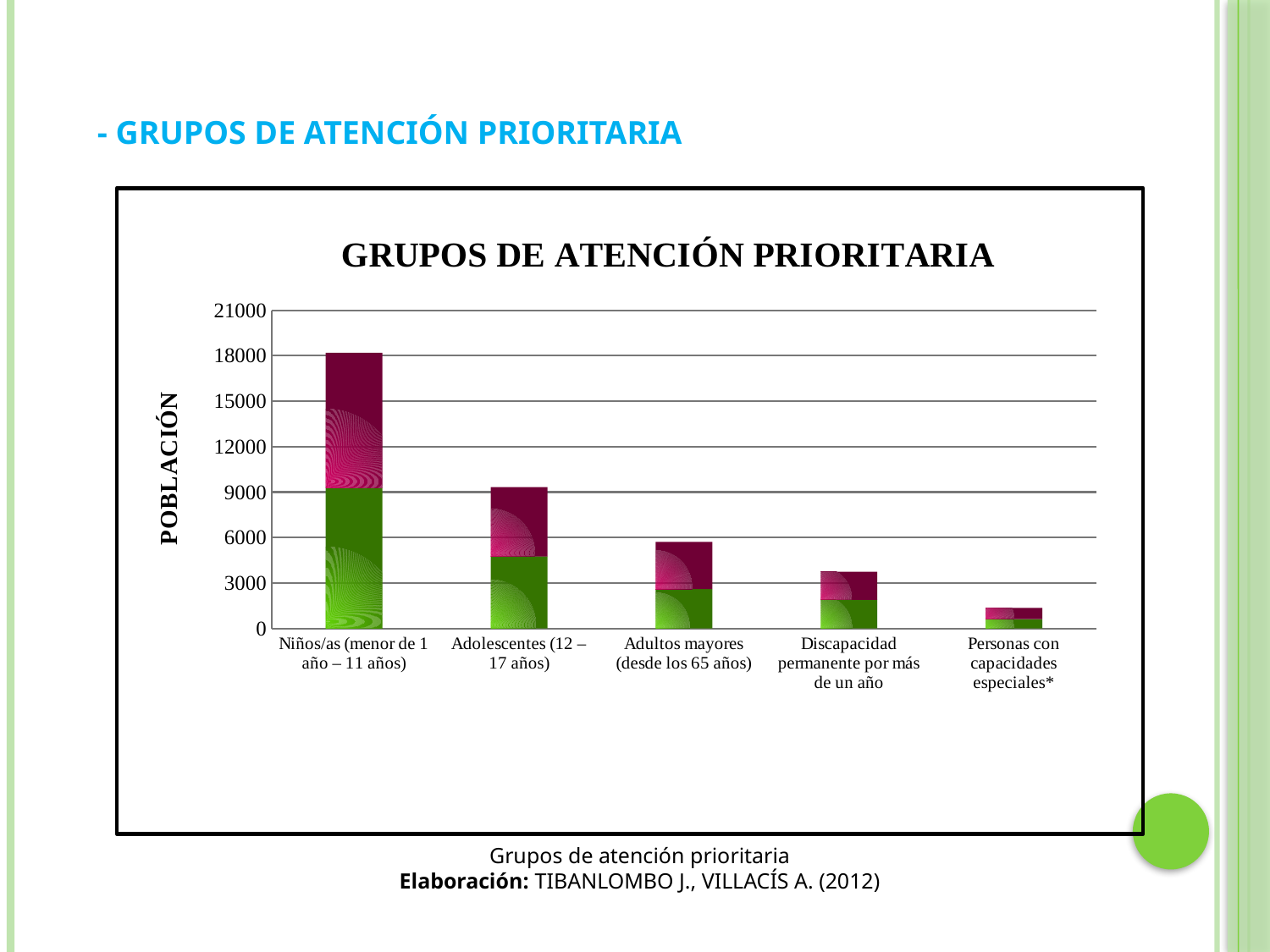
Which bar is taller: Discapacidad permanente por más de un año or Personas con capacidades especiales*? Discapacidad permanente por más de un año Is the total value for Adolescentes (12 – 17 años) greater or less than 12000? less How many categories are shown on the x axis of the chart? 5 Is the total value for Personas con capacidades especiales* greater or less than 3000? less What kind of chart is shown on the slide? Stacked bar chart What is the label on the vertical axis of the chart? POBLACIÓN Which category has the shortest bar in the chart? Personas con capacidades especiales* Which bar is taller: Adolescentes (12 – 17 años) or Adultos mayores (desde los 65 años)? Adolescentes (12 – 17 años) Is the total value for Discapacidad permanente por más de un año greater or less than 3000? greater Which category has the tallest bar in the chart? Niños/as (menor de 1 año – 11 años) Do the bar heights rise or fall moving from left to right along the x axis? Fall